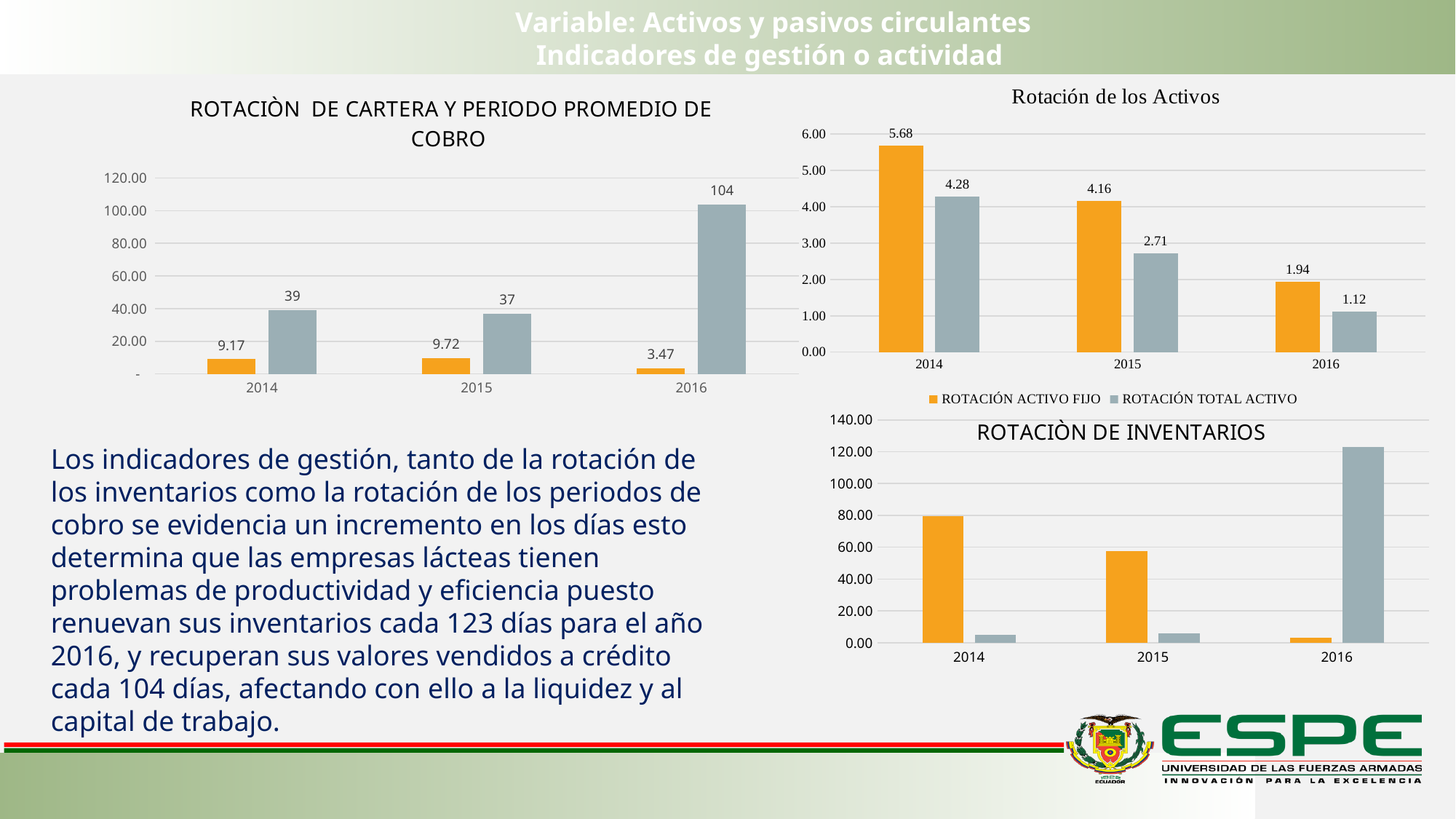
What kind of chart is 'ROTACIÒN DE INVENTARIOS'? bar chart In the 'ROTACIÒN DE CARTERA Y PERIODO PROMEDIO DE COBRO' chart, what is the value of the gray bar for 2016? 104 In the 'Rotación de los Activos' chart, what is the value of ROTACIÓN TOTAL ACTIVO for 2015? 2.71 In the 'Rotación de los Activos' chart, which year has the lowest ROTACIÓN ACTIVO FIJO? 2016 In the 'Rotación de los Activos' chart, how many series does the legend list? 2 In the 'Rotación de los Activos' chart, what is the value of ROTACIÓN ACTIVO FIJO for 2014? 5.68 In the 'ROTACIÒN DE CARTERA Y PERIODO PROMEDIO DE COBRO' chart, which year has the highest gray bar? 2016 In the 'ROTACIÒN DE INVENTARIOS' chart, is the value of the gray bar for 2016 greater or less than 100.00? greater In the 'Rotación de los Activos' chart, what is the difference between ROTACIÓN ACTIVO FIJO and ROTACIÓN TOTAL ACTIVO in 2016? 0.82 In the 'ROTACIÒN DE CARTERA Y PERIODO PROMEDIO DE COBRO' chart, how many years are shown on the x axis? 3 In the 'Rotación de los Activos' chart, does ROTACIÓN ACTIVO FIJO rise or fall from 2014 to 2016? fall In the 'ROTACIÒN DE CARTERA Y PERIODO PROMEDIO DE COBRO' chart, what is the value of the orange bar for 2015? 9.72